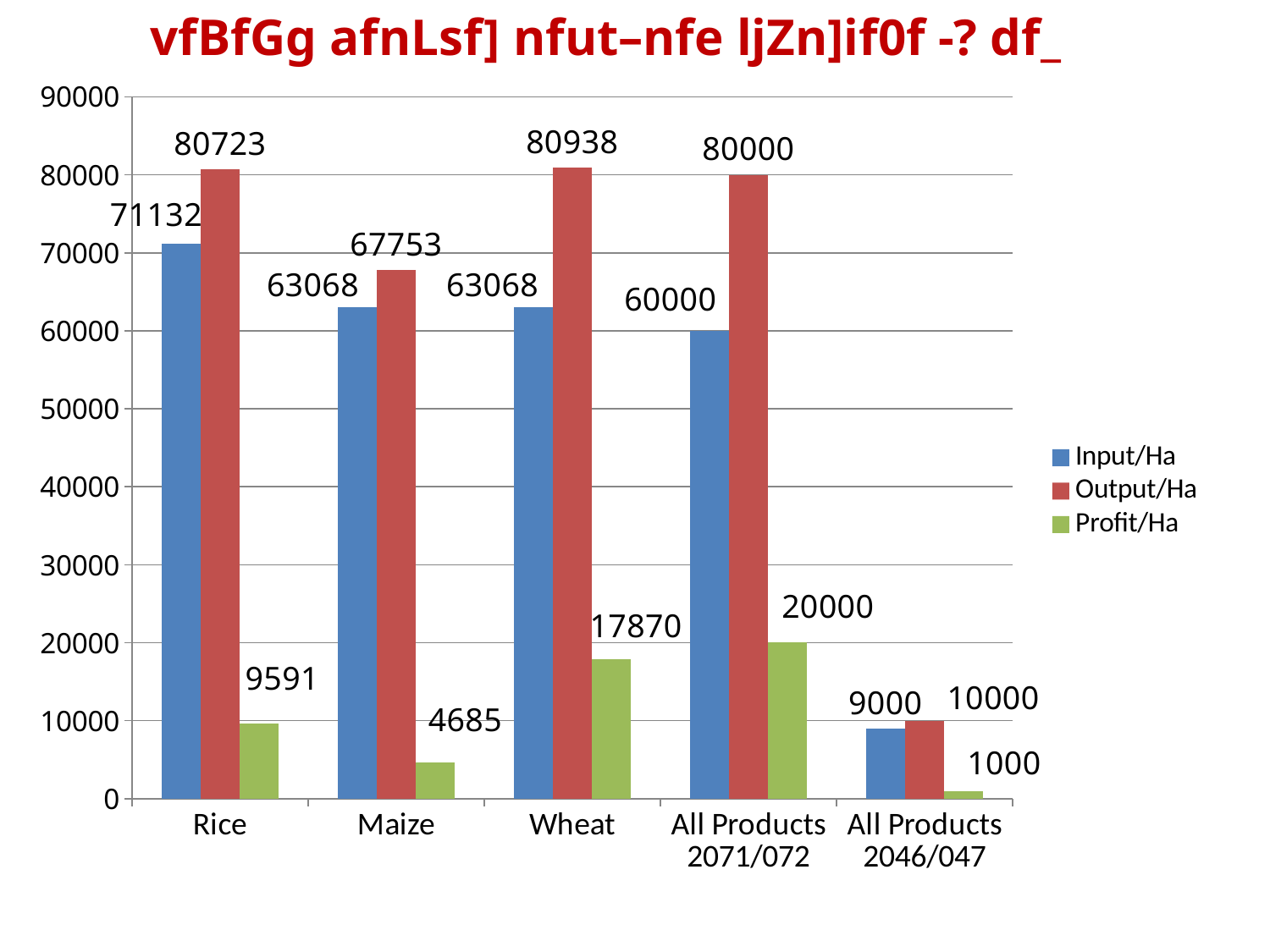
How many categories are shown on the x axis? 5 What is the difference between Output/Ha and Input/Ha for Maize? 4685 What is the Profit/Ha value for Maize? 4685 What is the Input/Ha value for Rice? 71132 What kind of chart is shown on the slide? bar chart What is the Output/Ha value for Wheat? 80938 Which category has the lowest Output/Ha? All Products 2046/047 Which is larger, the Profit/Ha for Wheat or the Profit/Ha for Rice? Wheat Which colour represents the Profit/Ha series? green Which category has the highest Profit/Ha? All Products 2071/072 Is the Input/Ha value for All Products 2046/047 greater or less than 10000? less How many series does the legend list? 3